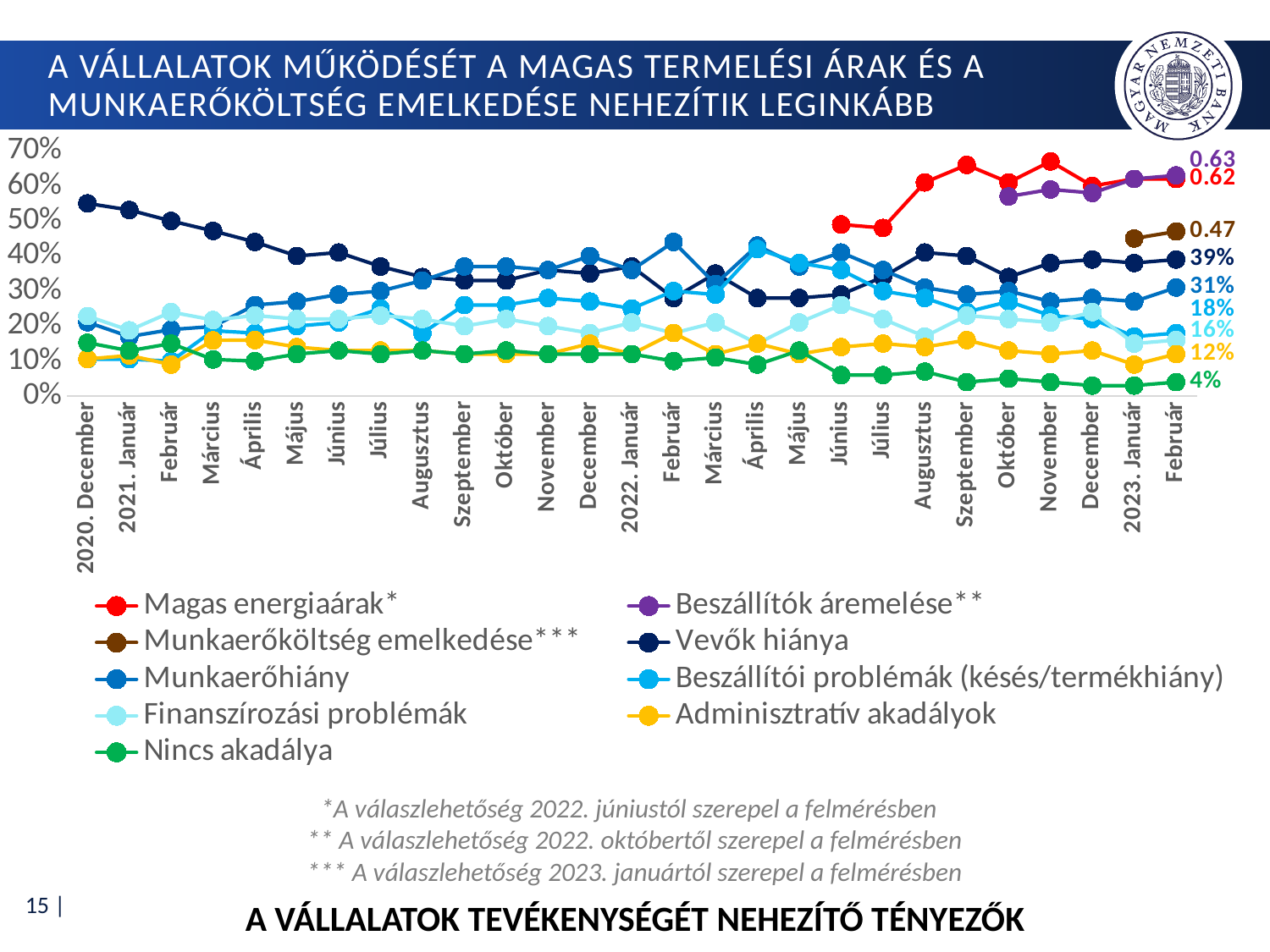
Is the value for Vevők hiánya in 2020. December greater or less than 50%? greater What is the difference between Vevők hiánya and Munkaerőhiány in 2023. Február? 8% What is the value for Munkaerőköltség emelkedése in 2023. Február? 0.47 What kind of chart is shown on the slide? line chart In 2023. Február, which is larger: Beszállítói problémák (késés/termékhiány) or Finanszírozási problémák? Beszállítói problémák (késés/termékhiány) Which series has the lowest value in 2023. Február? Nincs akadálya What is the value for Vevők hiánya in 2023. Február? 39% What is the value for Munkaerőhiány in 2023. Február? 31% How many series does the legend list? 9 Which series has the highest value in 2023. Február? Beszállítók áremelése Does the value for Vevők hiánya rise or fall overall from 2020. December to 2023. Február? fall What is the value for Nincs akadálya in 2023. Február? 4%